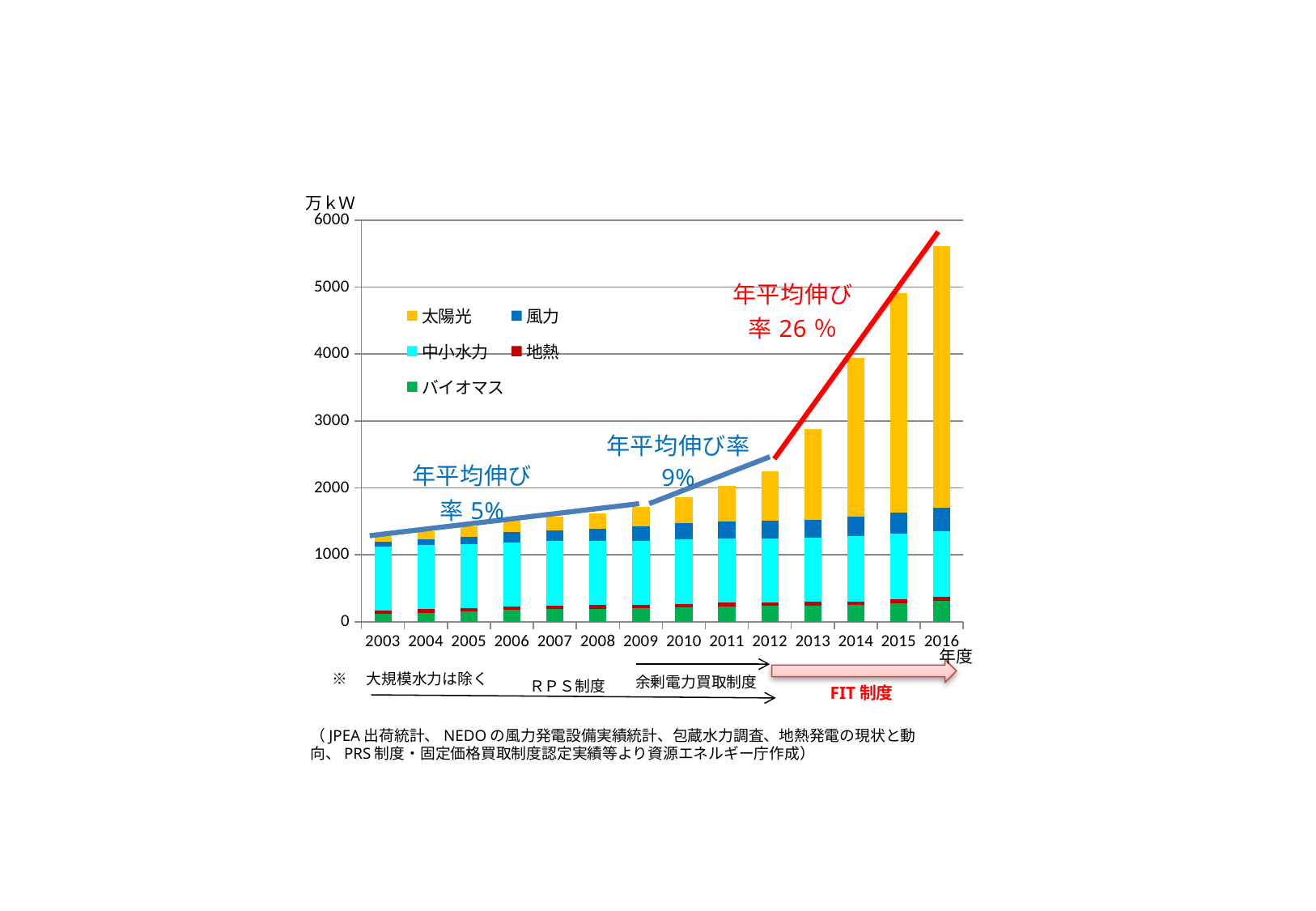
How many series does the legend list? 5 Do the total bar heights rise or fall from 2003 to 2016? rise What kind of chart is shown on the slide? stacked bar chart What annual average growth rate is annotated in red for the period after 2012? 26% How many years (categories) are plotted along the x axis? 14 Is the total value for 2003 greater or less than 2000? less Is the total value for 2016 greater or less than 5000? greater What unit is shown at the top of the y axis? 万kW Which year has the larger total bar, 2013 or 2015? 2015 Which year has the highest total bar? 2016 Is the total value for 2012 greater or less than 2000? greater Which year has the lowest total bar? 2003